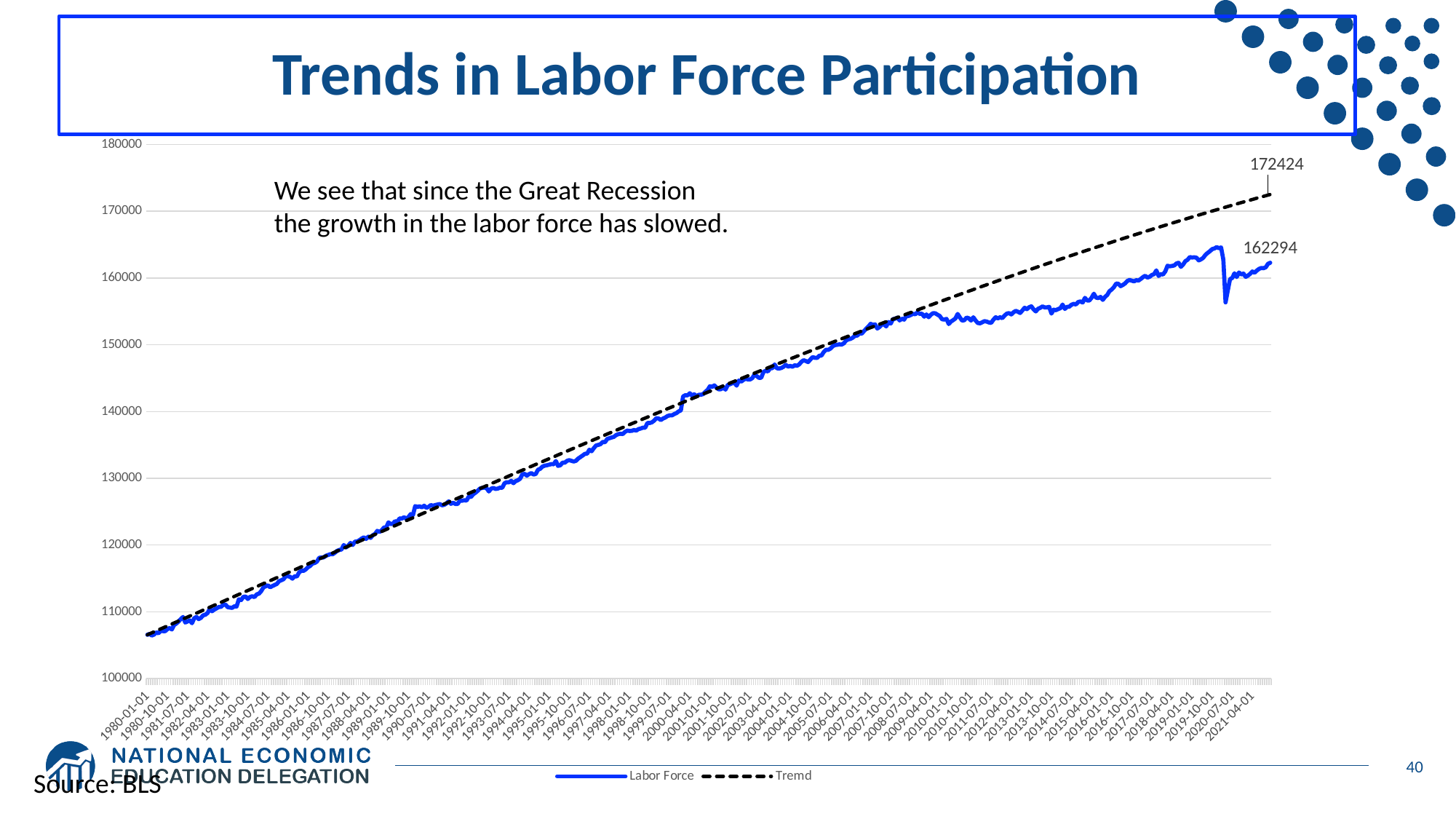
Does the Labor Force series generally rise or fall from 1980 to 2021? rise What is the final labeled value of the trend (Tremd) series? 172424 What kind of chart is shown on the slide? line chart What is the difference between the final labeled trend value and the final labeled Labor Force value? 10130 What are the two entries in the chart legend? Labor Force and Tremd What is the final labeled value of the Labor Force series? 162294 What is the title of the slide? Trends in Labor Force Participation Is the Labor Force value at 1980-01-01 greater or less than 110000? less At the end of the chart, which series is higher: Labor Force or the trend line? the trend line How many series does the legend list? 2 Is the Labor Force value at 1990-01-01 greater or less than 130000? less Is the Labor Force value at 2010-01-01 greater or less than 150000? greater